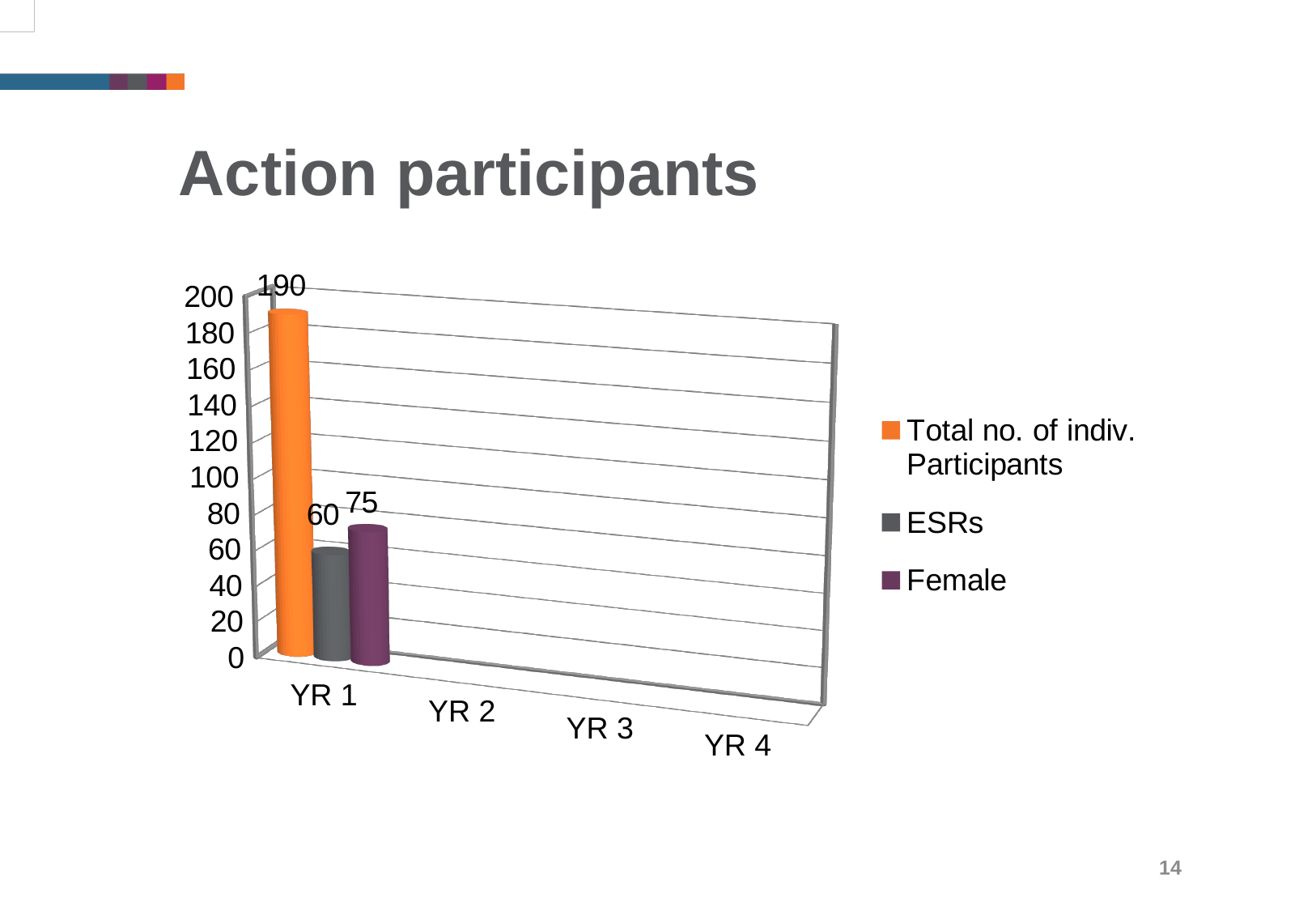
What is the value for ESRs in YR 1? 60 What is the value for Total no. of indiv. Participants in YR 1? 190 What is the difference between Female and ESRs in YR 1? 15 How many categories are shown on the x axis? 4 Is the value for Total no. of indiv. Participants in YR 1 greater or less than 100? greater Which series has the lowest value in YR 1? ESRs Which series has the highest value in YR 1? Total no. of indiv. Participants How many series does the legend list? 3 What is the value for Female in YR 1? 75 What is the difference between Total no. of indiv. Participants and Female in YR 1? 115 In YR 1, which is larger: ESRs or Female? Female What kind of chart is shown on the slide? bar chart